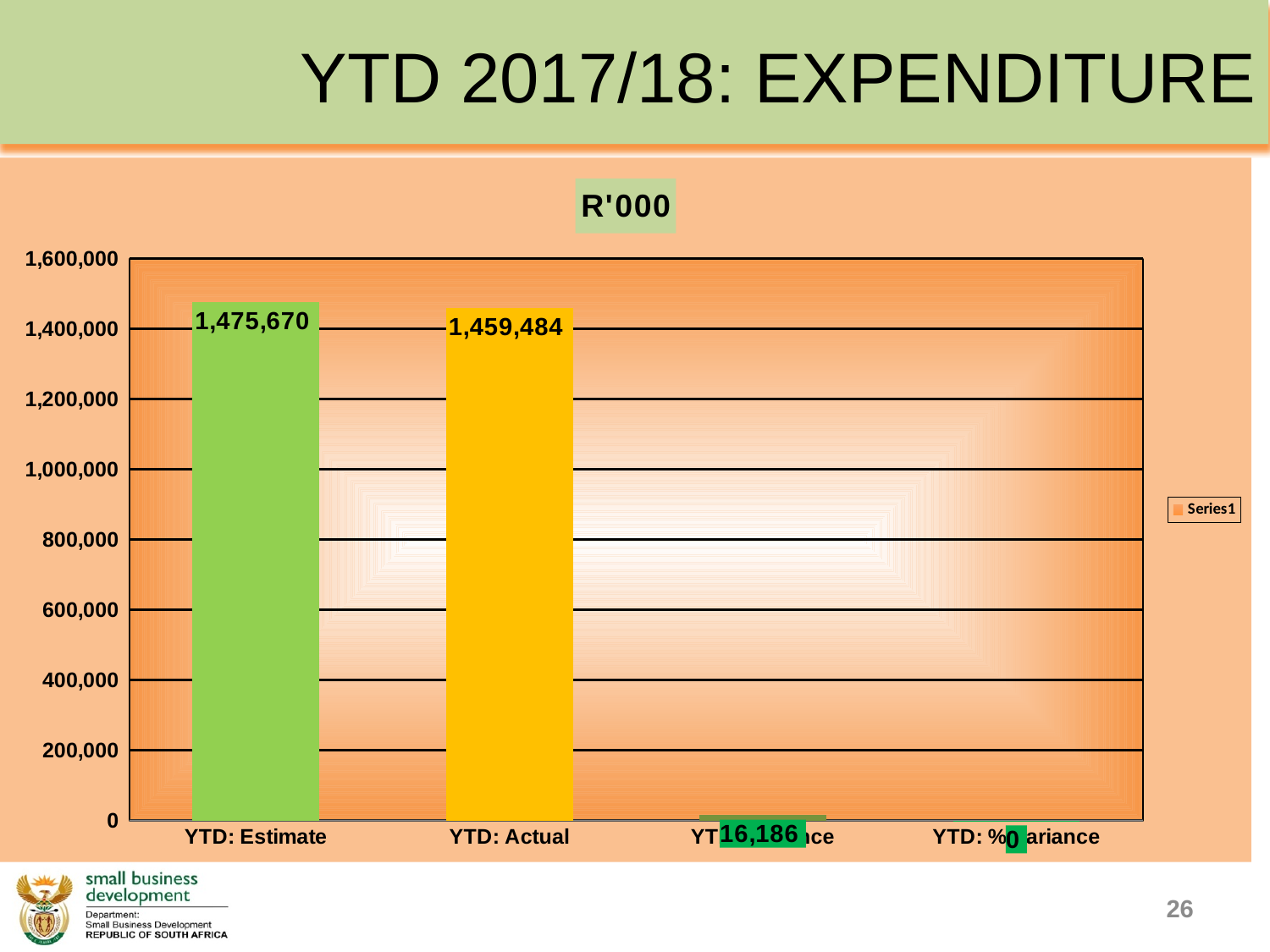
Which category has the highest value? YTD: Estimate What is the value shown for the fourth category, YTD: % Variance? 0 How many series does the legend list? 1 What is the difference between YTD: Estimate and YTD: Actual? 16,186 What is the value shown for the third category, YTD: Variance? 16,186 Is the value for YTD: Actual greater or less than 1,400,000? greater What kind of chart is shown on the slide? Bar chart What is the value for YTD: Estimate? 1,475,670 Which is larger, YTD: Estimate or YTD: Actual? YTD: Estimate What is the title of the chart? R'000 How many categories are shown on the x axis? 4 What is the value for YTD: Actual? 1,459,484